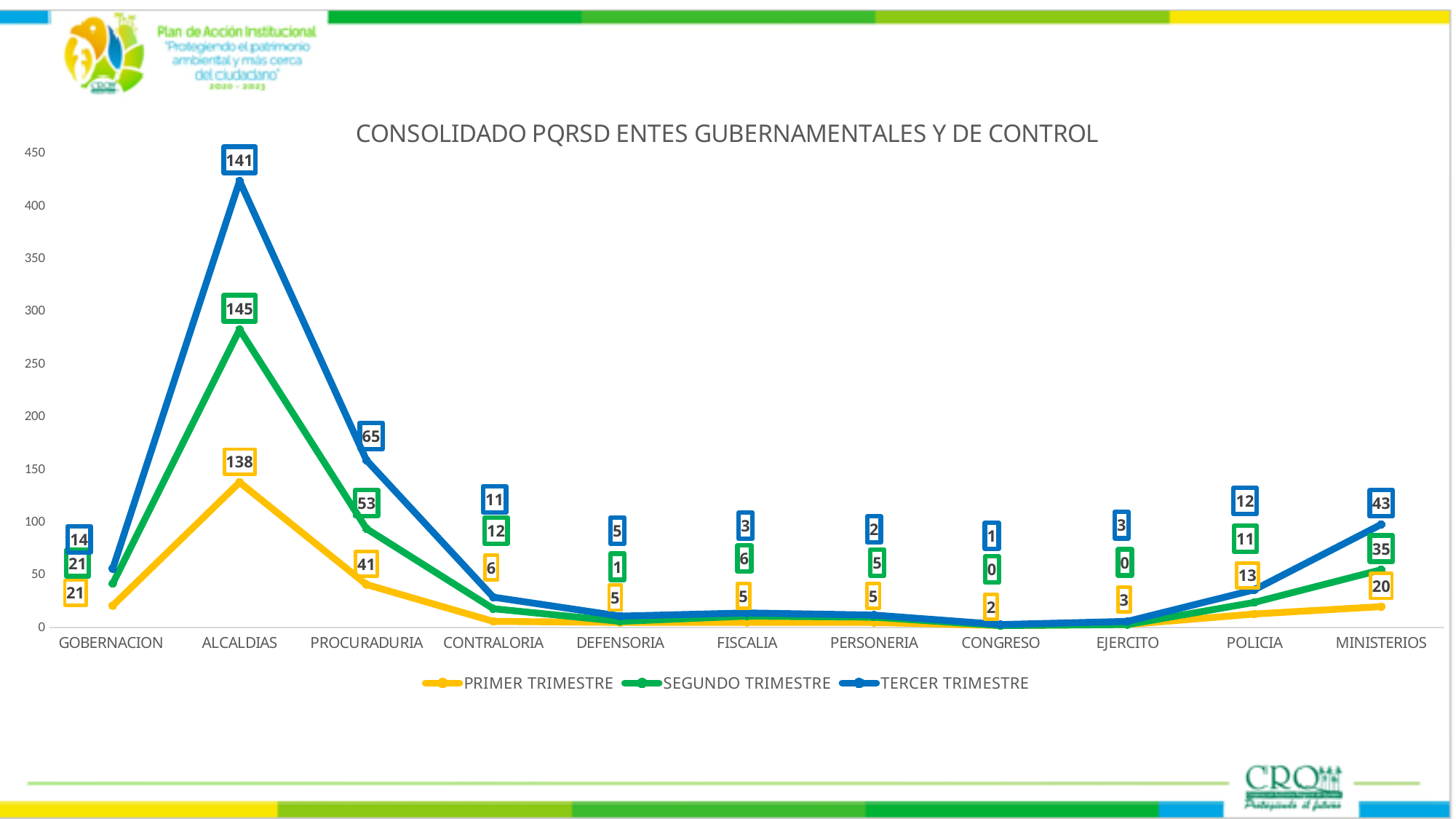
What is the value for MINISTERIOS in the TERCER TRIMESTRE series? 43 How many categories are shown on the x axis? 11 Which category has the lowest value in the TERCER TRIMESTRE series? CONGRESO Which category has the highest value in the PRIMER TRIMESTRE series? ALCALDIAS What is the value for ALCALDIAS in the PRIMER TRIMESTRE series? 138 What is the value for PROCURADURIA in the SEGUNDO TRIMESTRE series? 53 What is the difference between the SEGUNDO TRIMESTRE and PRIMER TRIMESTRE values for ALCALDIAS? 7 How many series does the legend list? 3 What is the total of the three series values for MINISTERIOS? 98 For PROCURADURIA, which is larger: the SEGUNDO TRIMESTRE value or the TERCER TRIMESTRE value? TERCER TRIMESTRE What is the title of the chart? CONSOLIDADO PQRSD ENTES GUBERNAMENTALES Y DE CONTROL What type of chart is shown on the slide? line chart